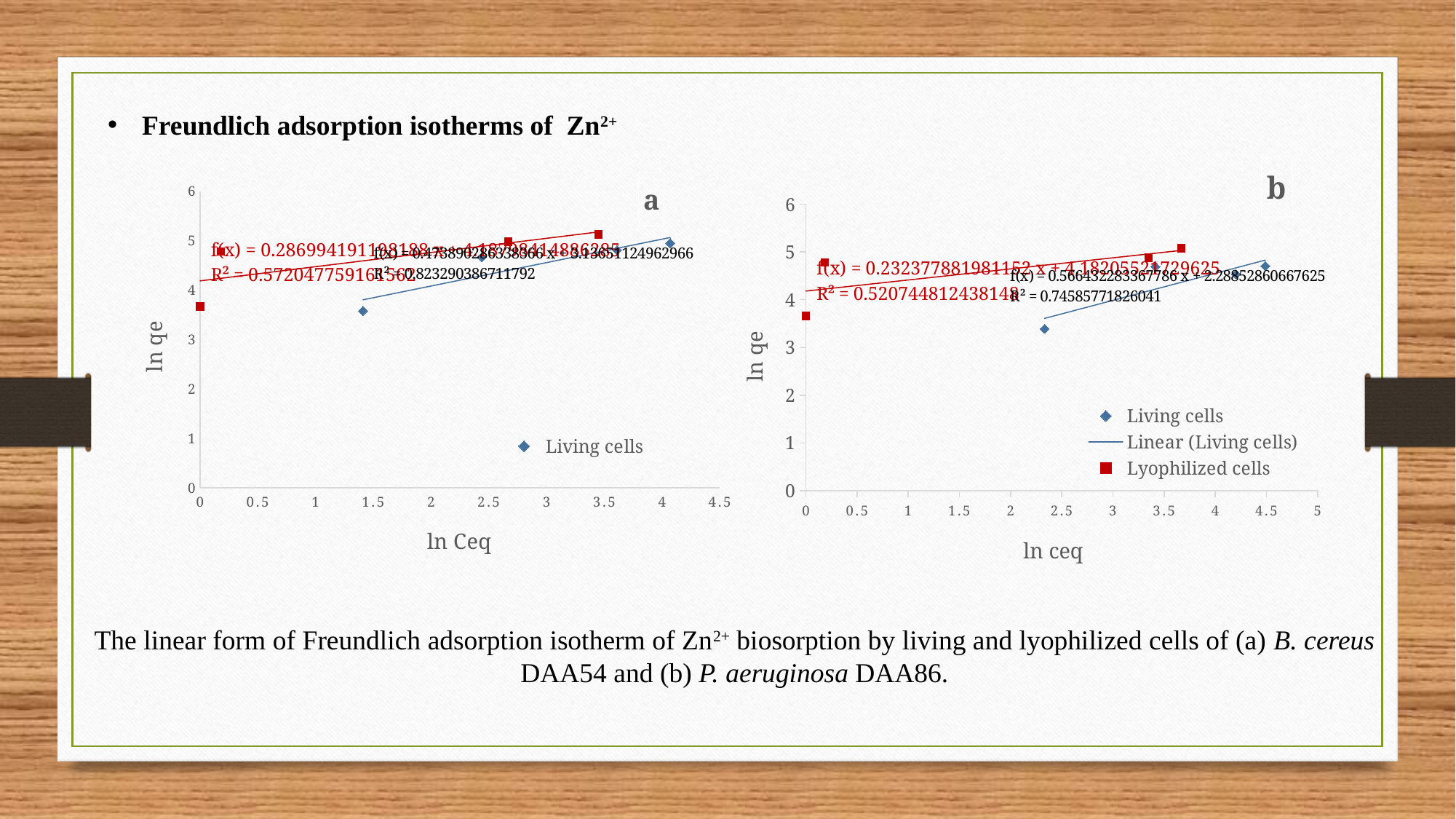
In chart b, what is the R² value printed for the Lyophilized cells trendline (red text)? 0.520744812438148 What kind of chart is chart a? scatter chart In chart a, what is the R² value printed in black for the Living cells trendline? 0.823290386711792 In chart b, which trendline has the higher R², Living cells or Lyophilized cells? Living cells What is the y-axis title of chart a? ln qe In chart a, which trendline has the higher R², the black (Living cells) one or the red one? the black (Living cells) one In chart b, is the ln qe value of the leftmost Living cells point (near ln ceq 2.3) greater or less than 4? less In chart b, do the Living cells values rise or fall as ln ceq increases? rise In chart b, what is the R² value printed for the Living cells trendline (black text)? 0.74585771826041 In chart a, is the ln qe value of the leftmost Living cells point (near ln Ceq 1.4) greater or less than 4? less How many Living cells data points are plotted in chart b? 4 How many series does the legend of chart b list? 3